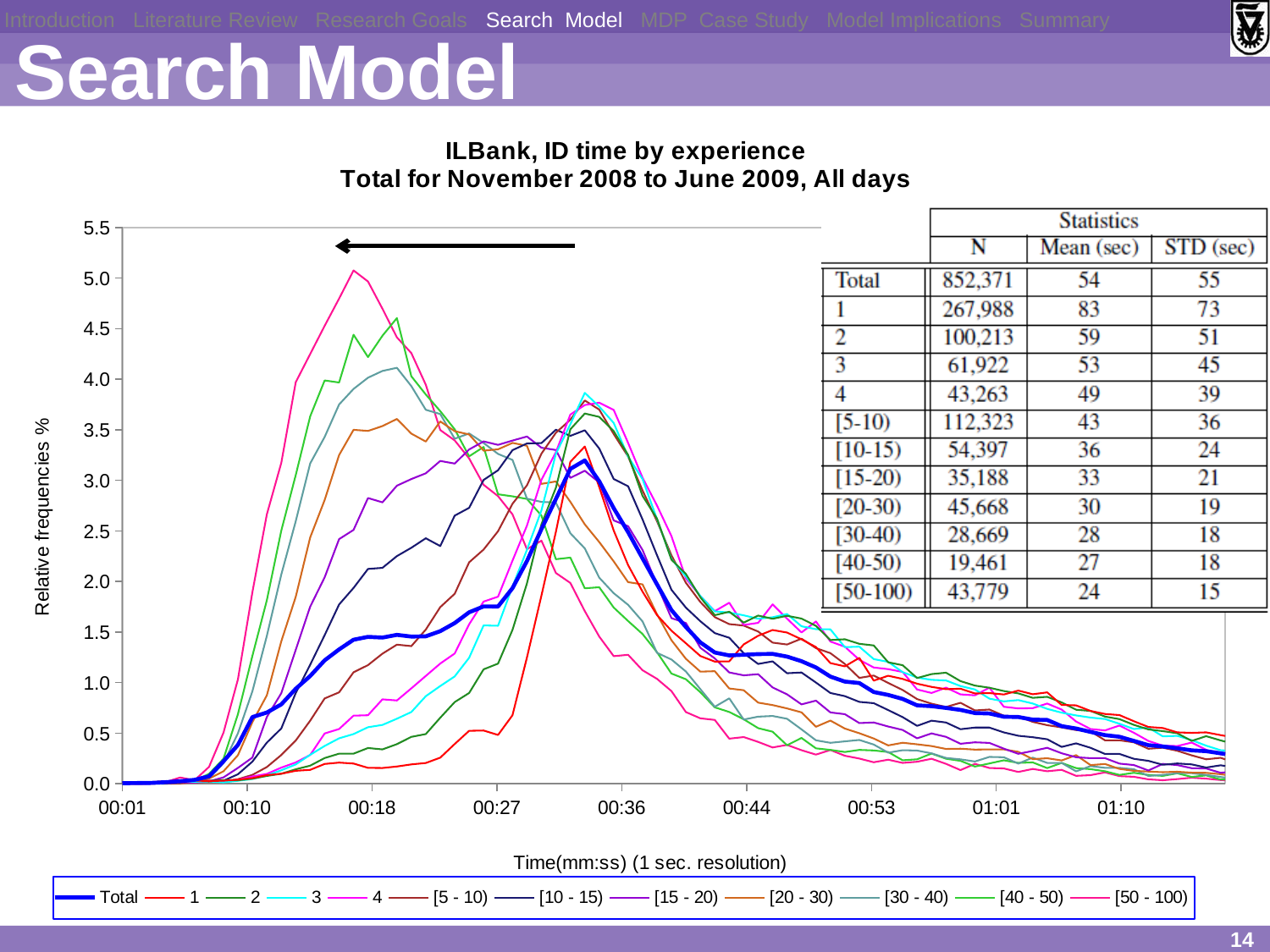
How many series does the chart legend list? 12 Which series reaches the highest peak on the chart? [50 - 100) What kind of chart is shown on the slide? Line chart In the Statistics table, what is N for experience group 1? 267,988 What is the label of the vertical axis of the chart? Relative frequencies % Is the peak value of the [50 - 100] series greater or less than 4.5? greater Is the peak value of the 1 series greater or less than 3.0? greater Is the peak value of the Total series greater or less than 3.0? greater In the Statistics table, what is the mean (sec) for the Total row? 54 What is the title of the chart? ILBank, ID time by experience Total for November 2008 to June 2009, All days In the Statistics table, which experience group has the lowest STD (sec)? [50-100)